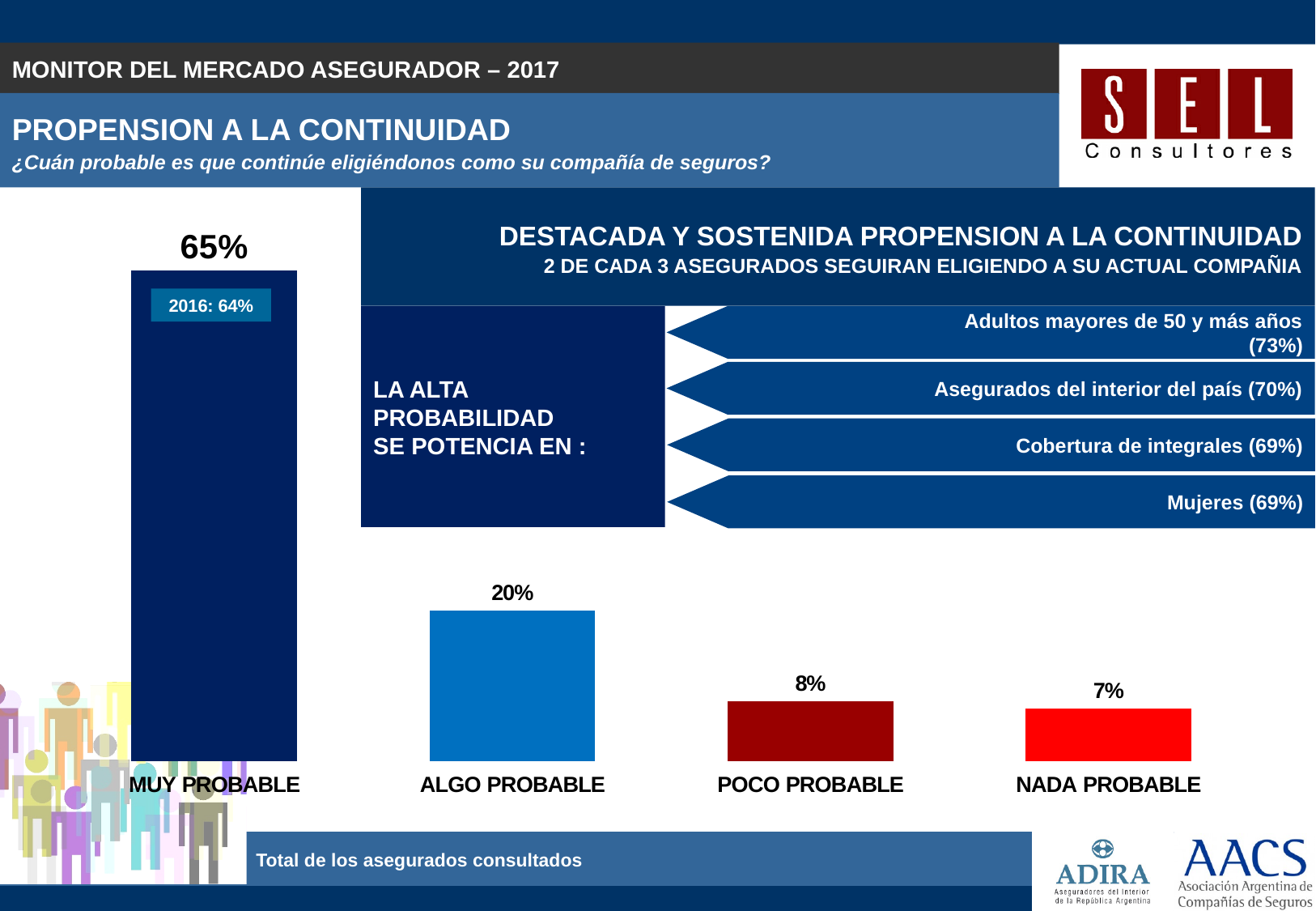
Which category has the lowest value? NADA PROBABLE What is the value for ALGO PROBABLE? 20% Which category has the highest value? MUY PROBABLE What was the value for MUY PROBABLE in 2016, as noted on the bar? 64% What kind of chart is shown on the slide? bar chart How many categories are shown in the bar chart? 4 What is the value for POCO PROBABLE? 8% Which is larger, the value for ALGO PROBABLE or the value for POCO PROBABLE? ALGO PROBABLE What is the value for NADA PROBABLE? 7% What is the value for MUY PROBABLE? 65% What is the difference between the values for POCO PROBABLE and NADA PROBABLE? 1% What is the difference between the values for MUY PROBABLE and ALGO PROBABLE? 45%